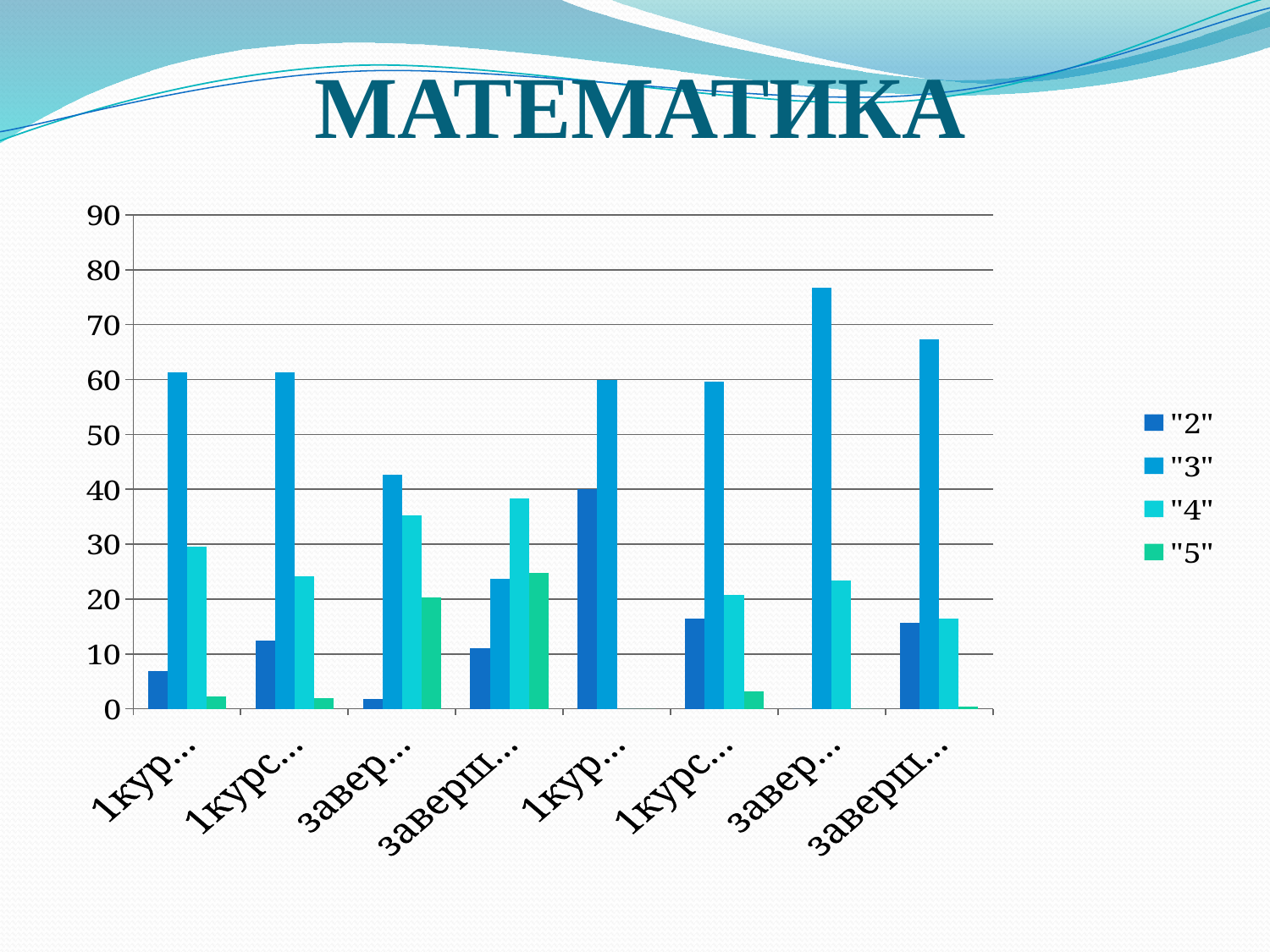
In the seventh category from the left, is the value for "3" greater or less than 70? greater Is the tallest bar in the chart greater or less than 70? greater What kind of chart is shown on the slide? bar chart In the fourth category from the left, which is larger, the value for "4" or the value for "2"? "4" Which series has the tallest bar anywhere in the chart? "3" In the first category from the left, which is larger, the value for "3" or the value for "4"? "3" In the third category from the left, is the value for "3" greater or less than 50? less What are the entries listed in the legend? "2", "3", "4", "5" How many categories are plotted along the x axis? 8 How many series does the legend list? 4 What is the title of the slide above the chart? МАТЕМАТИКА